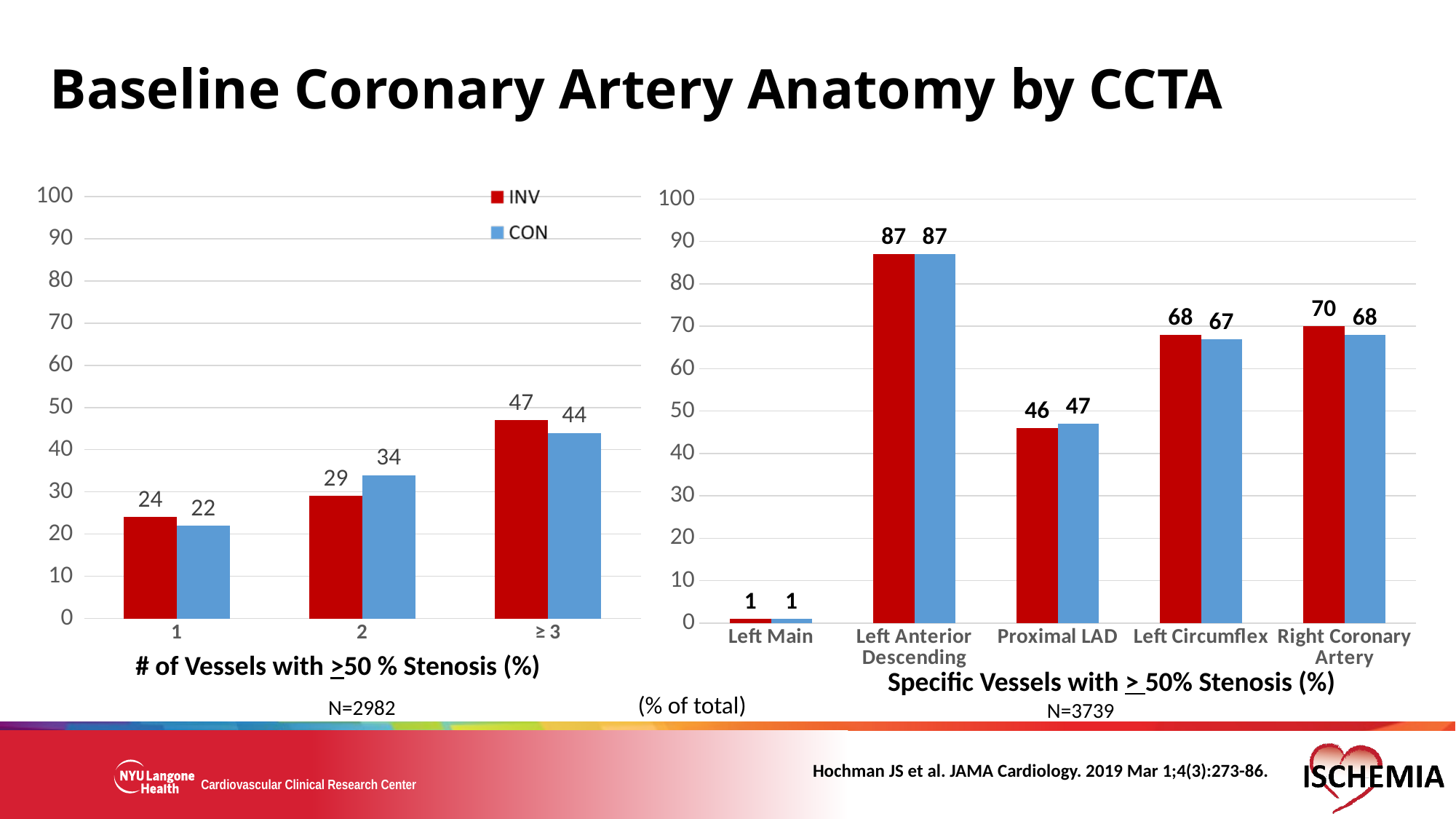
In the left chart (# of Vessels with ≥50% Stenosis), which category has the highest INV value? ≥ 3 In the right chart (Specific Vessels with ≥50% Stenosis), how many vessel categories are shown? 5 In the left chart (# of Vessels with ≥50% Stenosis), what is the INV value for 1 vessel? 24 In the right chart (Specific Vessels with ≥50% Stenosis), what is the INV value for Proximal LAD? 46 In the right chart (Specific Vessels with ≥50% Stenosis), which vessel has the highest CON value? Left Anterior Descending In the right chart (Specific Vessels with ≥50% Stenosis), which vessel has the lowest INV value? Left Main In the right chart (Specific Vessels with ≥50% Stenosis), what is the CON value for Right Coronary Artery? 68 What type of chart is the left chart (# of Vessels with ≥50% Stenosis)? bar chart In the right chart (Specific Vessels with ≥50% Stenosis), is the INV value for Left Circumflex larger or smaller than the INV value for Proximal LAD? larger In the left chart (# of Vessels with ≥50% Stenosis), what is the CON value for 2 vessels? 34 In the left chart (# of Vessels with ≥50% Stenosis), how many series does the legend list? 2 In the left chart (# of Vessels with ≥50% Stenosis), what is the difference between the INV and CON values for ≥ 3 vessels? 3